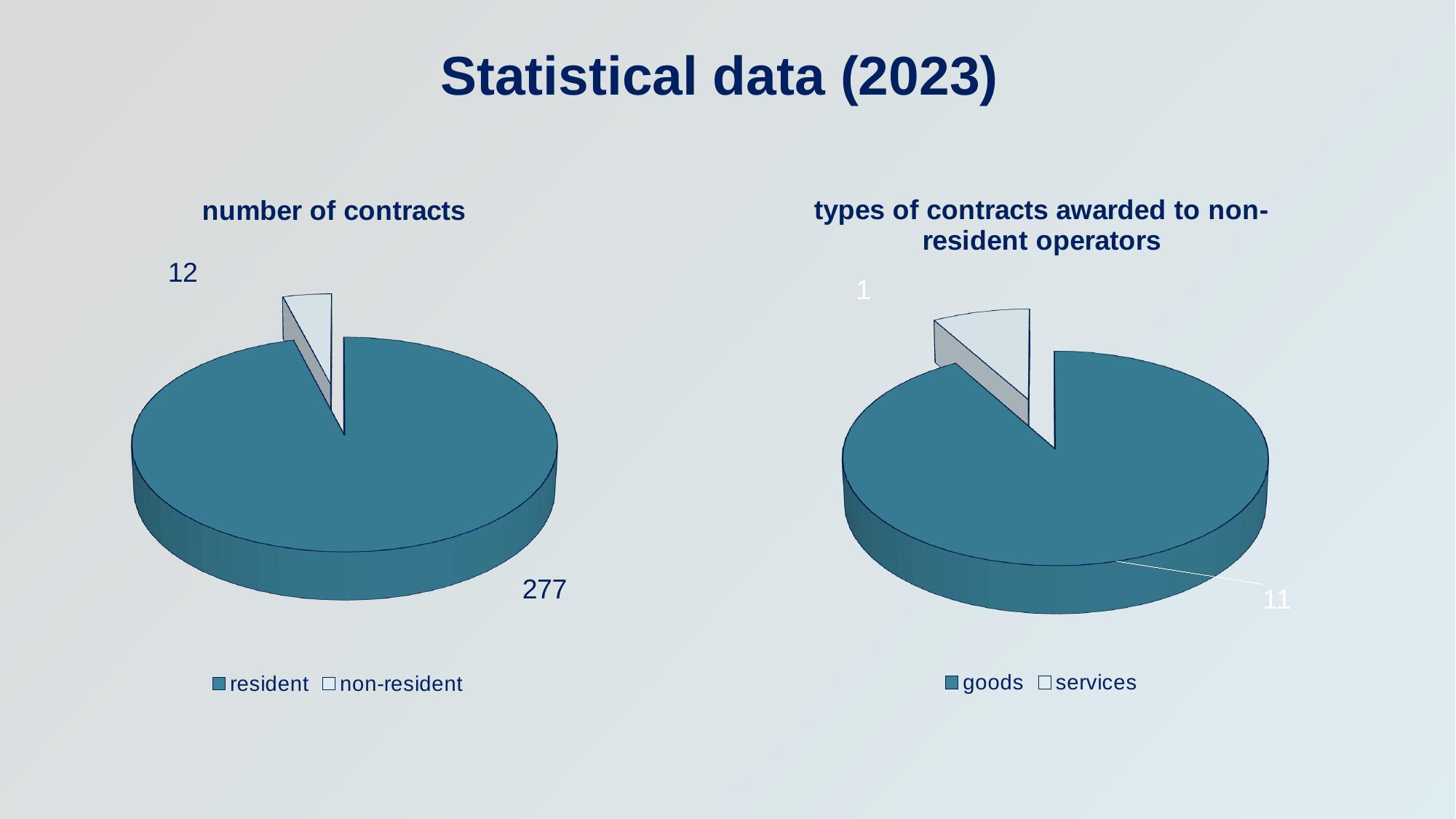
In the 'types of contracts awarded to non-resident operators' chart, what is the difference between goods and services? 10 In the 'number of contracts' chart, what is the value for resident? 277 In the 'number of contracts' chart, what is the value for non-resident? 12 In the 'types of contracts awarded to non-resident operators' chart, which category has the smallest slice? services What kind of chart is the 'number of contracts' chart? pie chart In the 'number of contracts' chart, what is the total of the two slices? 289 What is the title of the chart on the left of the slide? number of contracts In the 'number of contracts' chart, which category has the largest slice? resident In the 'types of contracts awarded to non-resident operators' chart, what is the value for services? 1 In the 'types of contracts awarded to non-resident operators' chart, what is the value for goods? 11 In the 'number of contracts' chart, what is the difference between the resident and non-resident values? 265 How many categories does the legend of the 'types of contracts awarded to non-resident operators' chart list? 2